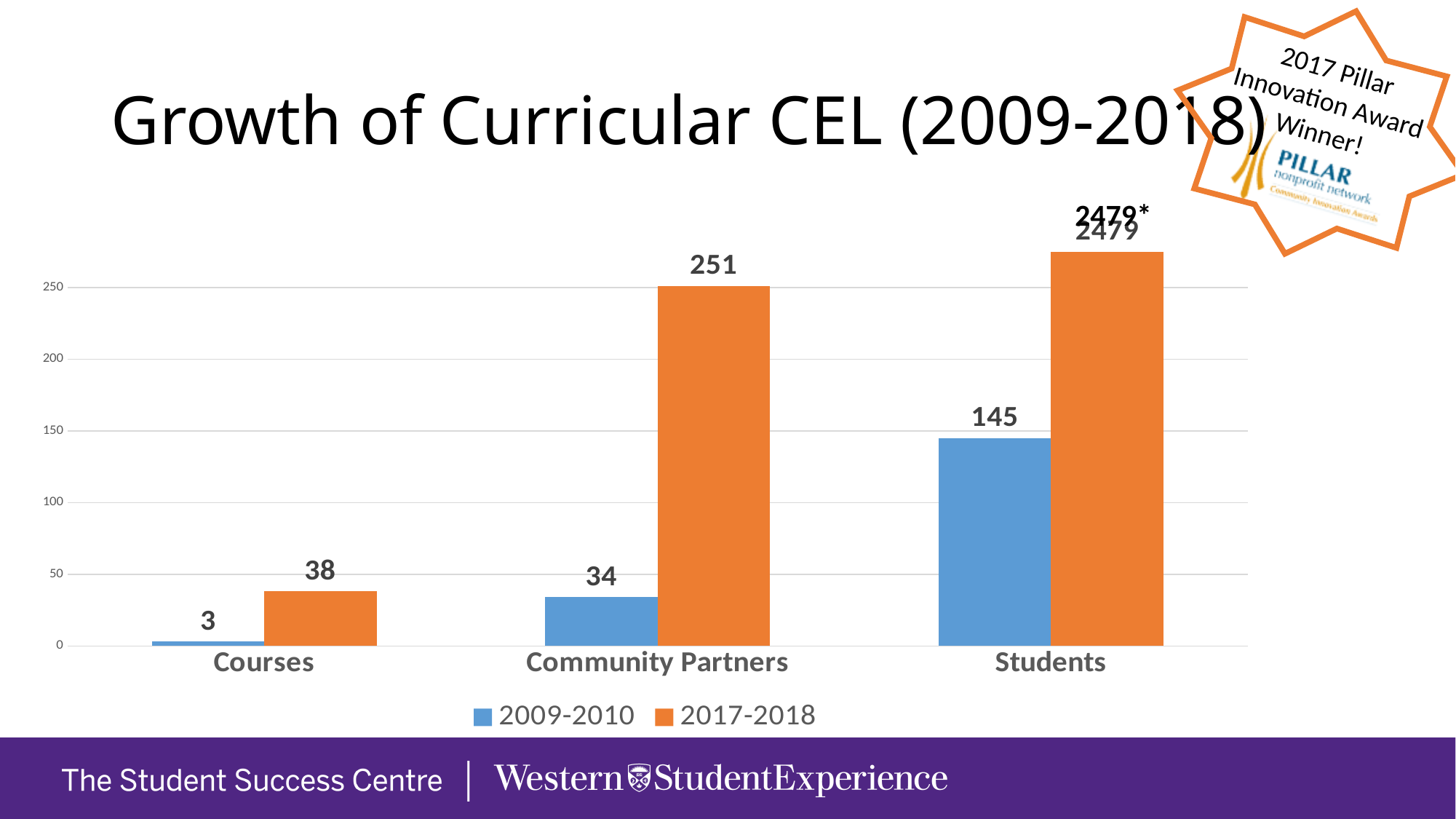
What is the difference between the 2017-2018 and 2009-2010 values for Community Partners? 217 What is the value for Courses in 2017-2018? 38 What is the value for Courses in 2009-2010? 3 What kind of chart is shown on the slide? bar chart Which is larger: the 2009-2010 value for Students or the 2017-2018 value for Courses? 2009-2010 value for Students What is the value for Community Partners in 2017-2018? 251 How many categories are shown on the x axis? 3 How many series does the legend list? 2 Which category has the highest value for 2009-2010? Students Which colour represents the 2017-2018 series? orange What is the value for Students in 2009-2010? 145 Which category has the lowest value for 2017-2018? Courses